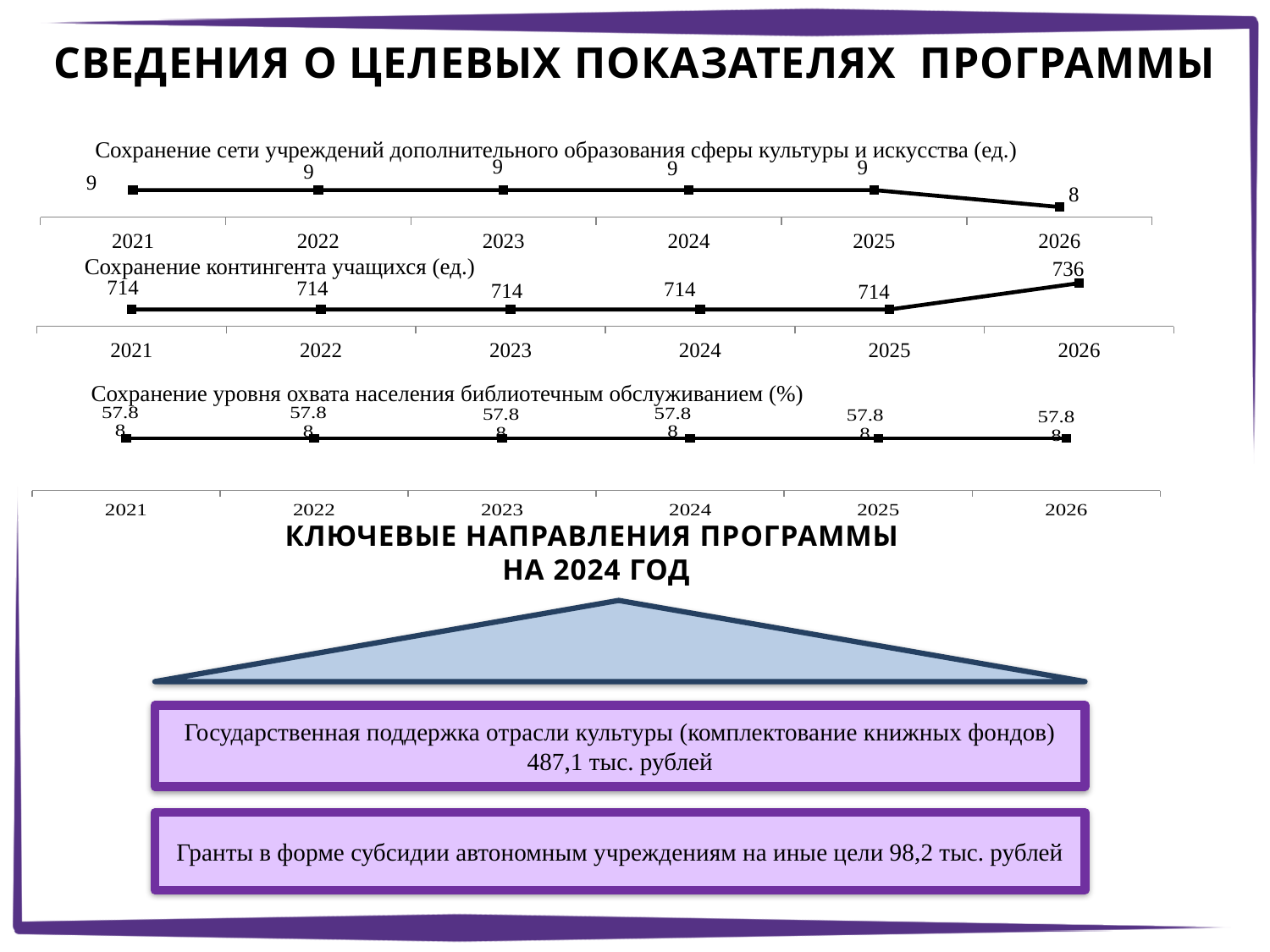
In the chart 'Сохранение контингента учащихся (ед.)', which is larger, the value for 2024 or the value for 2026? 2026 In the chart 'Сохранение контингента учащихся (ед.)', what is the value for 2023? 714 In the chart 'Сохранение сети учреждений дополнительного образования сферы культуры и искусства (ед.)', what is the value for 2021? 9 In the chart 'Сохранение сети учреждений дополнительного образования сферы культуры и искусства (ед.)', which year has the lowest value? 2026 In the chart 'Сохранение сети учреждений дополнительного образования сферы культуры и искусства (ед.)', what is the value for 2026? 8 In the chart 'Сохранение контингента учащихся (ед.)', what is the value for 2026? 736 In the chart 'Сохранение контингента учащихся (ед.)', which year has the highest value? 2026 How many years are plotted in the chart 'Сохранение уровня охвата населения библиотечным обслуживанием (%)'? 6 In the chart 'Сохранение сети учреждений дополнительного образования сферы культуры и искусства (ед.)', what is the difference between the values for 2025 and 2026? 1 What kind of chart is 'Сохранение контингента учащихся (ед.)'? line chart In the chart 'Сохранение контингента учащихся (ед.)', what is the difference between the values for 2026 and 2025? 22 In the chart 'Сохранение сети учреждений дополнительного образования сферы культуры и искусства (ед.)', does the value rise or fall from 2025 to 2026? fall